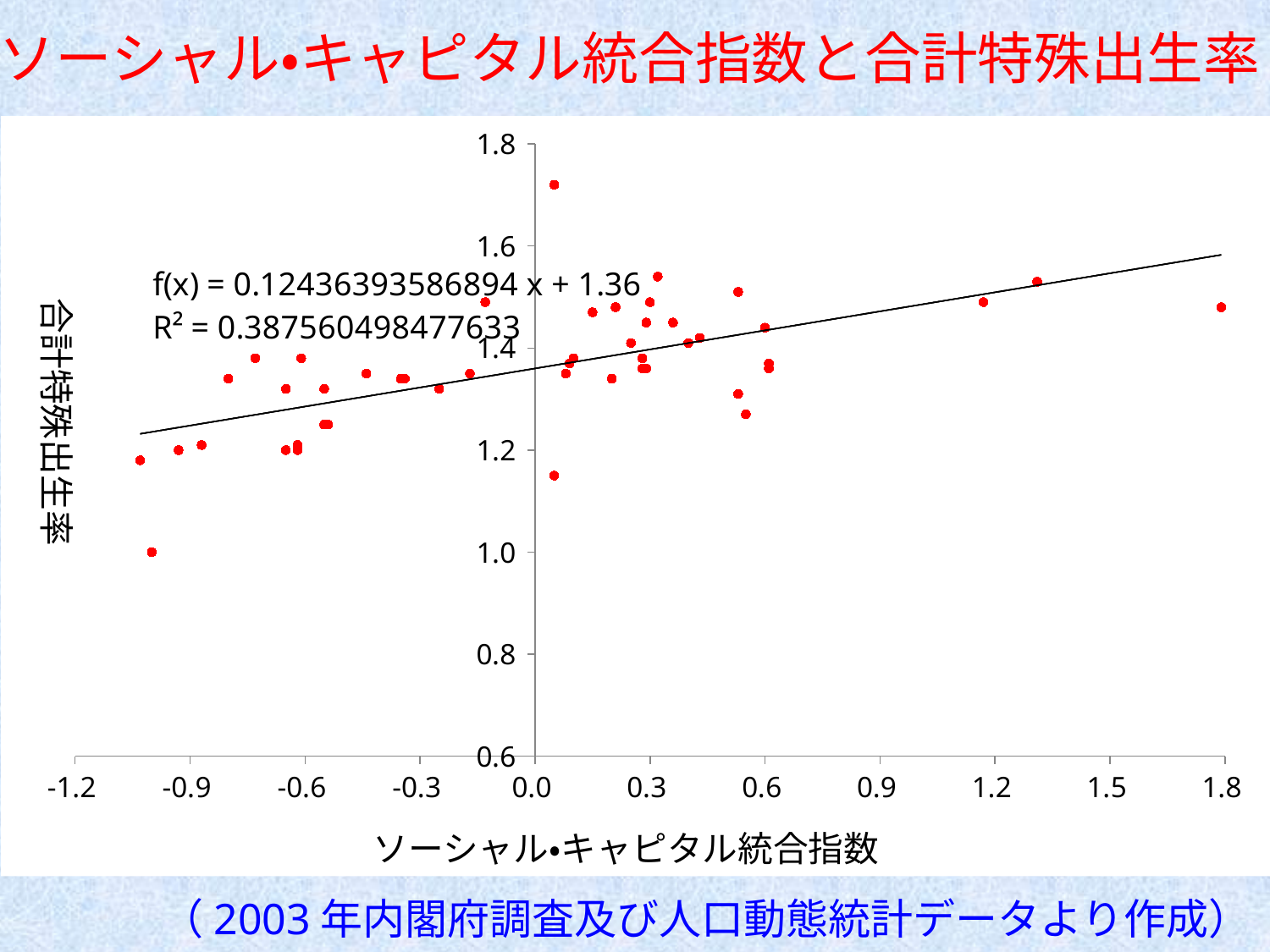
Does the trendline rise or fall as the social capital index increases along the x axis? rises What is the minimum value shown on the y axis? 0.6 What R² value is printed on the chart? 0.387560498477633 What is the equation of the trendline printed on the chart? f(x) = 0.12436393586894 x + 1.36 What is the intercept of the trendline shown on the chart? 1.36 What is the maximum value shown on the x axis? 1.8 What is the label of the x axis? ソーシャル•キャピタル統合指数 What is the title of the chart? ソーシャル•キャピタル統合指数と合計特殊出生率 Is the highest plotted total fertility rate greater or less than 1.6? greater What is the slope of the trendline shown on the chart? 0.12436393586894 Is the lowest plotted total fertility rate greater or less than 1.2? less What kind of chart is shown on the slide? scatter chart